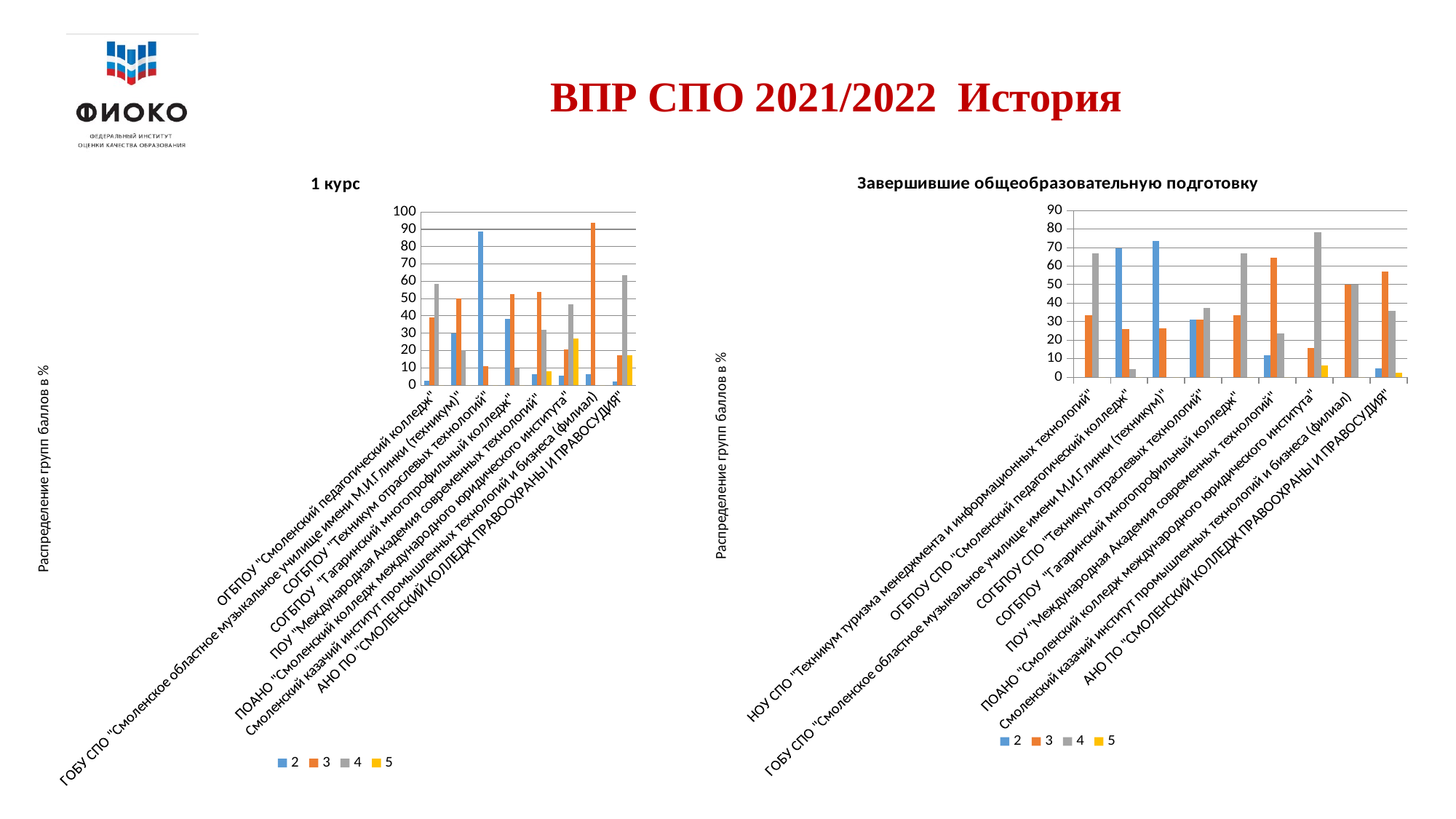
In the chart titled "1 курс", is the value of series 3 for Смоленский казачий институт промышленных технологий и бизнеса (филиал) greater or less than 90? greater How many categories are shown on the x axis of the chart titled "1 курс"? 8 In the chart titled "Завершившие общеобразовательную подготовку", which series has the highest value for ПОАНО "Смоленский колледж международного юридического института"? 4 In the chart titled "1 курс", for ОГБПОУ "Смоленский педагогический колледж", which is larger: series 3 or series 4? 4 How many series does the legend of the chart titled "1 курс" list? 4 What is the y-axis label of the chart titled "Завершившие общеобразовательную подготовку"? Распределение групп баллов в % In the chart titled "Завершившие общеобразовательную подготовку", is the value of series 2 for ОГБПОУ "Смоленский педагогический колледж" greater or less than 60? greater What type of chart is the chart titled "1 курс"? bar chart How many categories are shown on the x axis of the chart titled "Завершившие общеобразовательную подготовку"? 9 In the chart titled "1 курс", is the value of series 2 for СОГБПОУ "Техникум отраслевых технологий" greater or less than 80? greater In the chart titled "1 курс", which series has the highest value for Смоленский казачий институт промышленных технологий и бизнеса (филиал)? 3